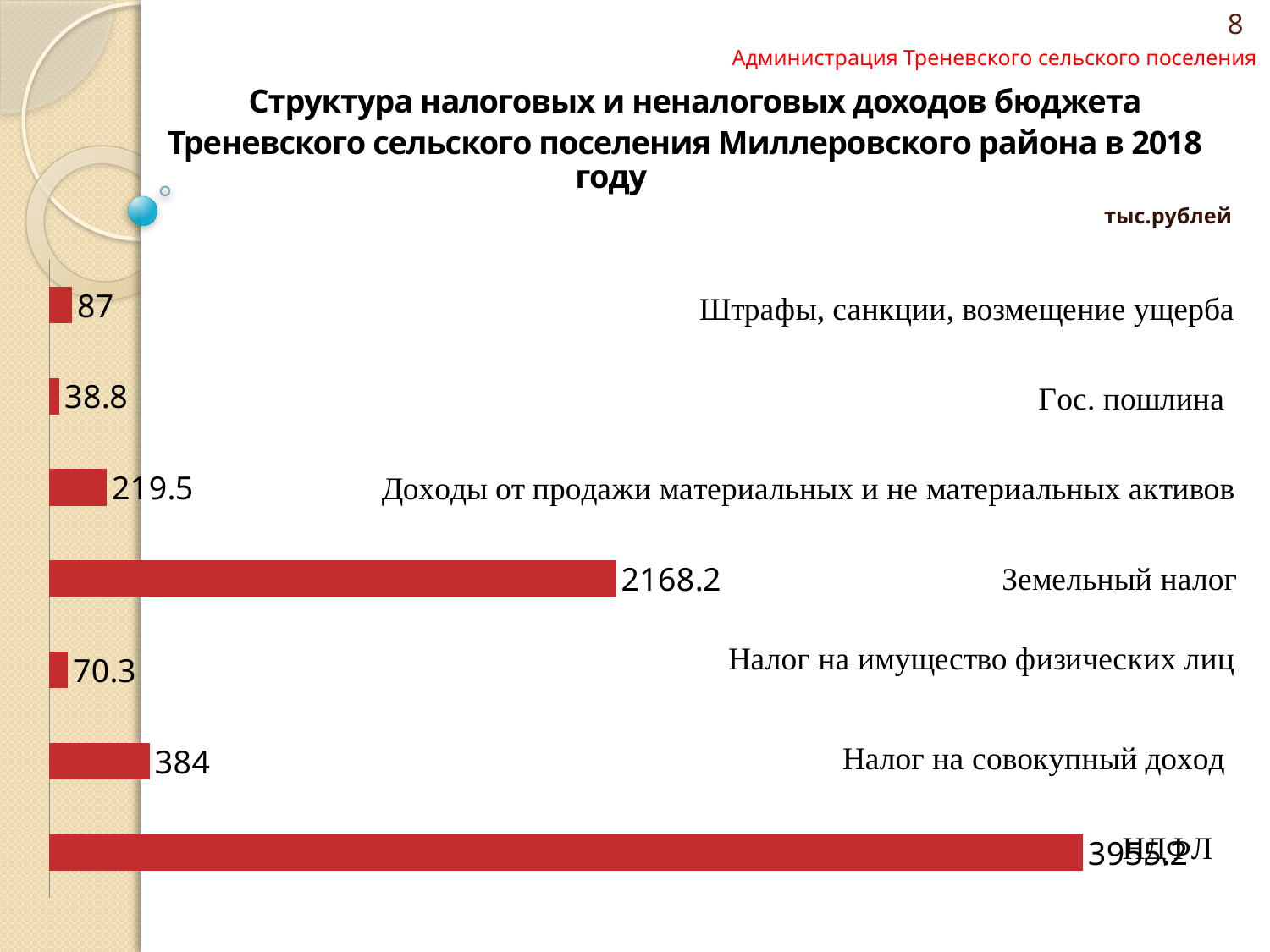
Which category has the highest value? НДФЛ What is the value for Доходы от продажи материальных и не материальных активов? 219.5 What is the value for Налог на совокупный доход? 384 What is the value for Гос. пошлина? 38.8 How many categories are shown in the chart? 7 What is the value for Земельный налог? 2168.2 What is the value for Налог на имущество физических лиц? 70.3 What is the value for Штрафы, санкции, возмещение ущерба? 87 Which is larger: the value for Штрафы, санкции, возмещение ущерба or the value for Налог на имущество физических лиц? Штрафы, санкции, возмещение ущерба What is the difference between the values for Земельный налог and Налог на совокупный доход? 1784.2 What kind of chart is shown on the slide? bar chart Which category has the lowest value? Гос. пошлина